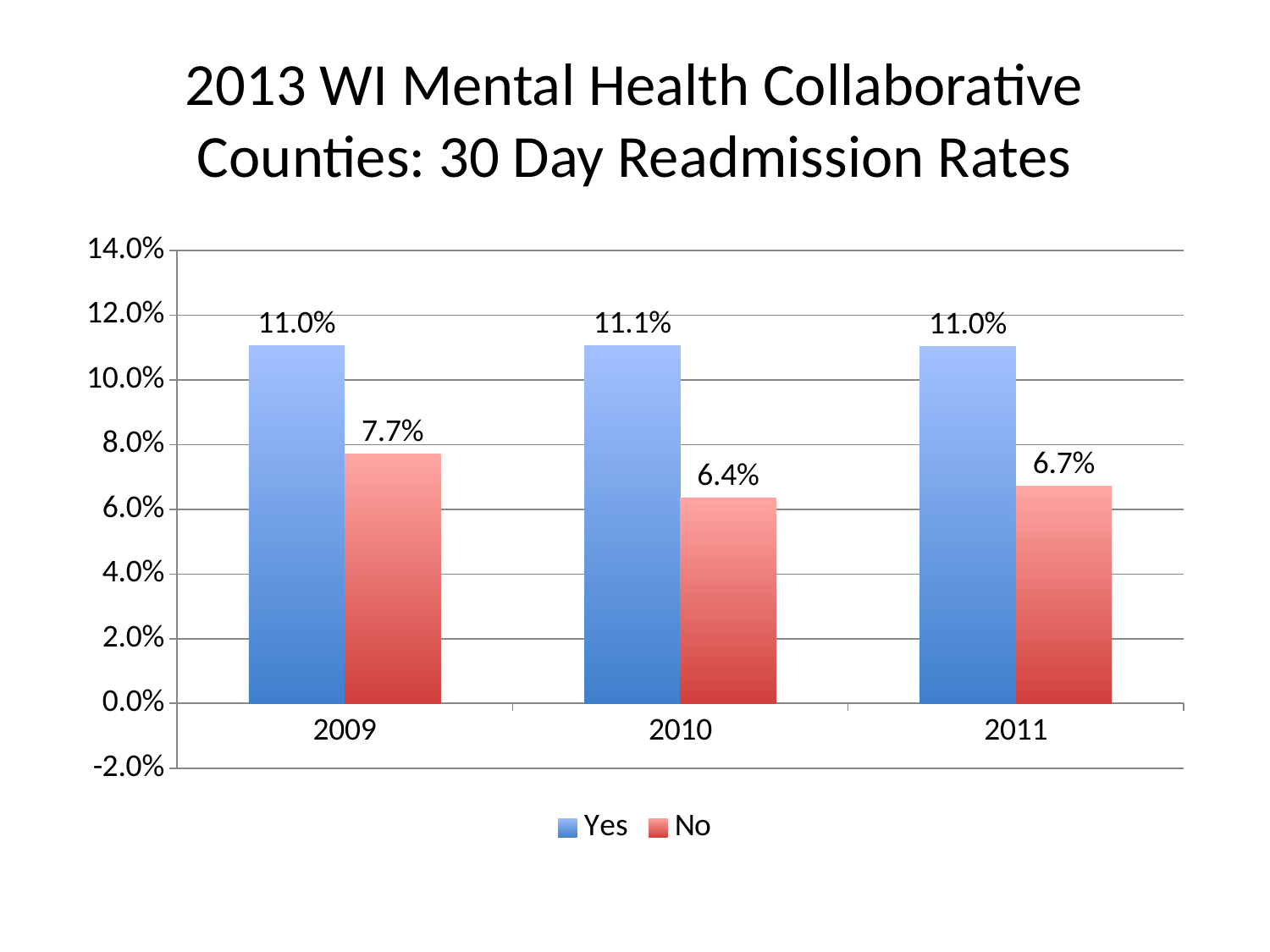
Which is larger in 2011, the Yes value or the No value? Yes How many years are shown on the x axis? 3 What is the 30 day readmission rate for the No series in 2011? 6.7% In which year is the No series highest? 2009 What is the difference between the Yes and No values in 2009? 3.3% What is the value for the Yes series in 2010? 11.1% What is the 30 day readmission rate for the Yes series in 2009? 11.0% In which year is the No series lowest? 2010 How many series does the legend list? 2 What is the 30 day readmission rate for the No series in 2010? 6.4% What kind of chart is shown on the slide? Bar chart What is the difference between the Yes and No values in 2010? 4.7%